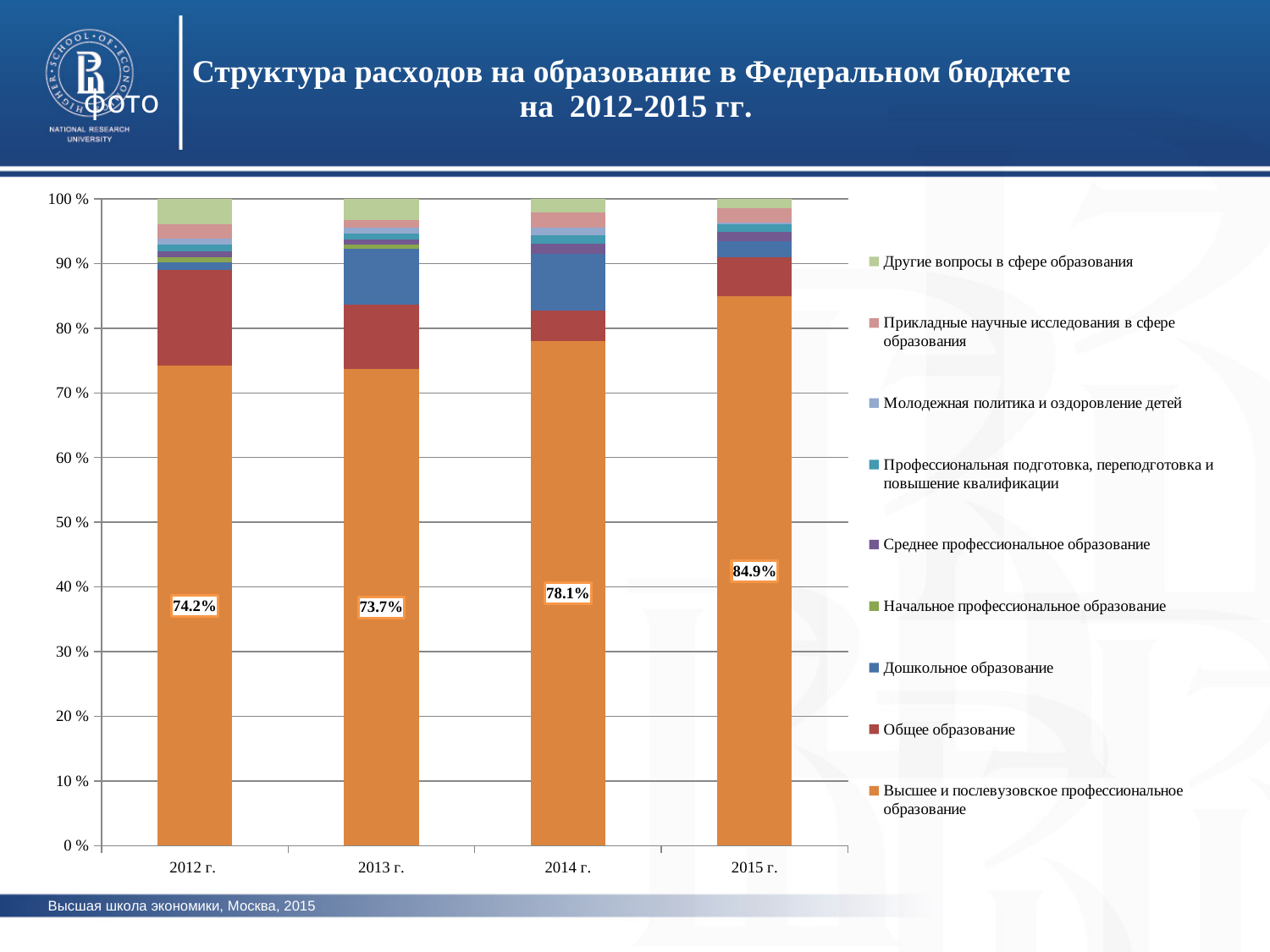
How many series does the legend list? 9 By how many percentage points does the share of Высшее и послевузовское профессиональное образование in 2015 г. exceed that in 2012 г.? 10.7 What is the value for Высшее и послевузовское профессиональное образование in 2015 г.? 84.9% Which year has the larger share of Высшее и послевузовское профессиональное образование, 2012 г. or 2014 г.? 2014 г. Does the share of Высшее и послевузовское профессиональное образование rise or fall from 2013 г. to 2015 г.? Rise In which year is the share of Высшее и послевузовское профессиональное образование the lowest? 2013 г. What is the value for Высшее и послевузовское профессиональное образование in 2014 г.? 78.1% What kind of chart is shown on the slide? Stacked bar chart How many years are shown on the x axis? 4 In which year is the share of Высшее и послевузовское профессиональное образование the highest? 2015 г. What is the value for Высшее и послевузовское профессиональное образование in 2013 г.? 73.7% What is the value for Высшее и послевузовское профессиональное образование in 2012 г.? 74.2%